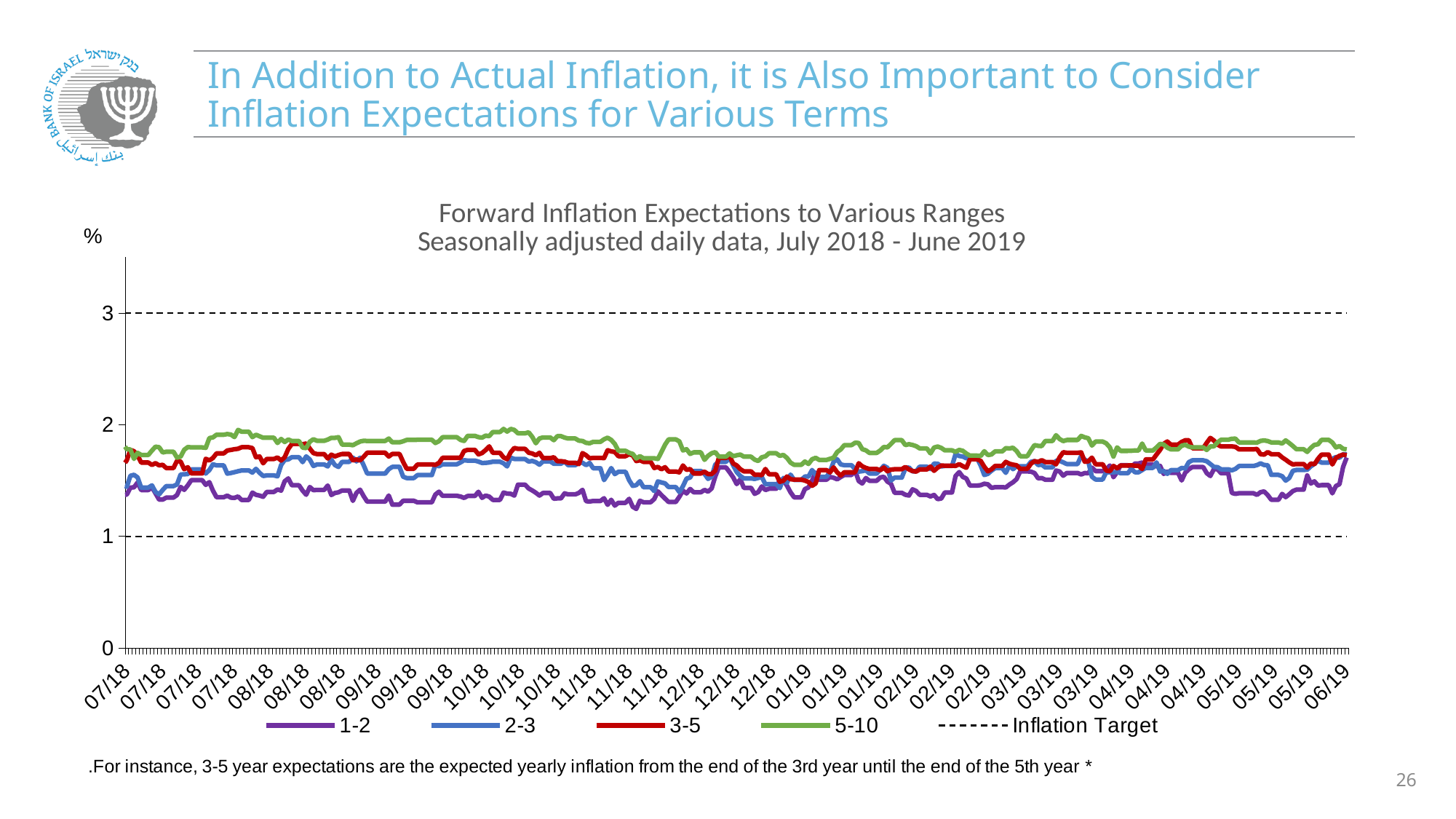
Which series is generally the highest across the chart? 5-10 What is the title of the chart? Forward Inflation Expectations to Various Ranges What kind of chart is shown on the slide? Line chart Is the value of the 1-2 series greater or less than 1 throughout the period? greater In 11/18, which series is higher: 5-10 or 1-2? 5-10 Which series is generally the lowest across the chart? 1-2 Is the value of the 5-10 series greater or less than 3 throughout the period? less At which two values on the y axis are the Inflation Target dashed lines drawn? 1 and 3 Do all four expectation series stay between the two Inflation Target lines over the whole period? Yes What period does the chart's subtitle say the daily data covers? July 2018 - June 2019 How many entries does the chart's legend list? 5